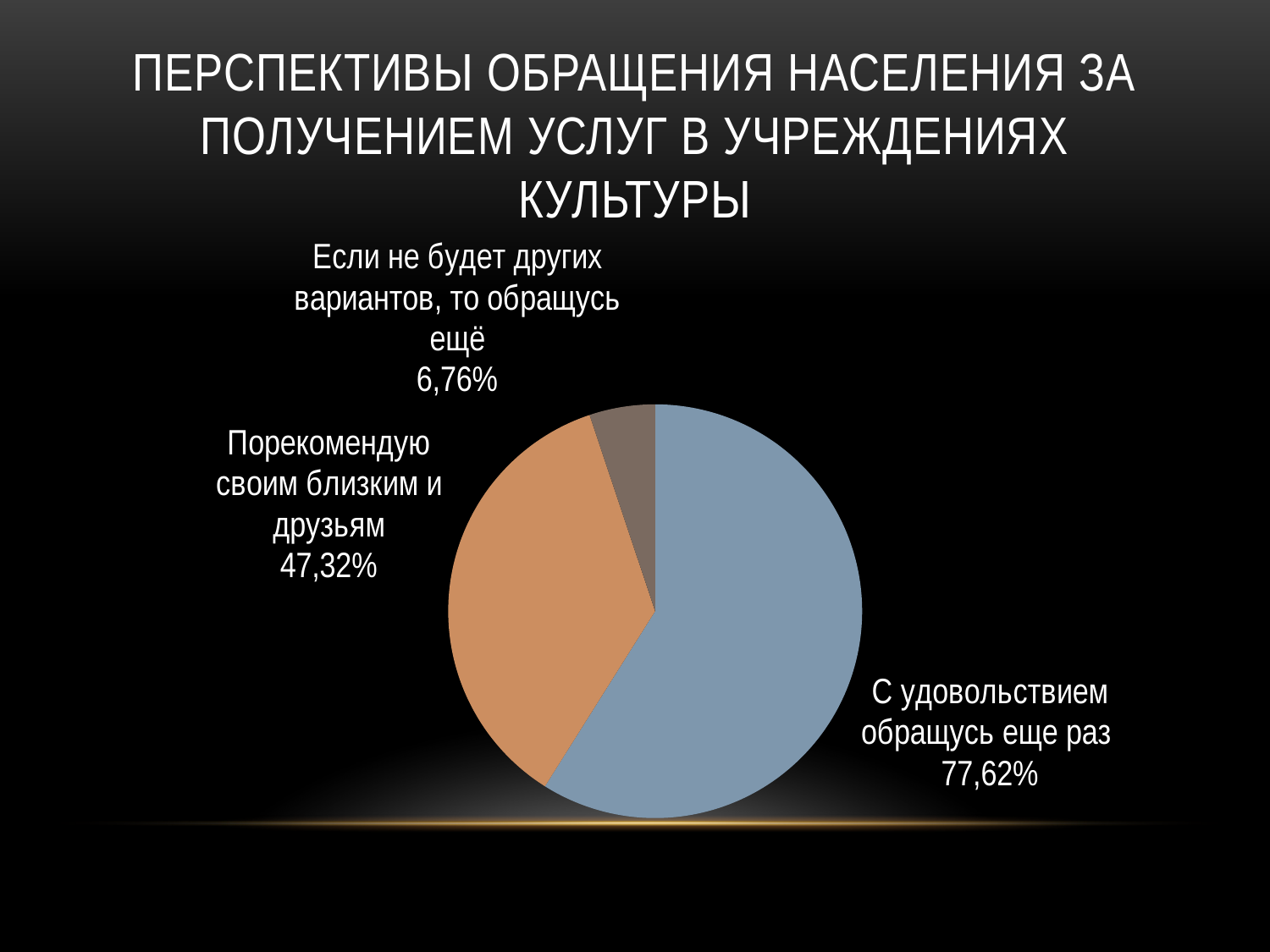
Which category has the largest slice of the pie? С удовольствием обращусь еще раз What percentage is shown for "Порекомендую своим близким и друзьям"? 47,32% What kind of chart is shown on the slide? pie chart What is the difference between the percentages for "Порекомендую своим близким и друзьям" and "Если не будет других вариантов, то обращусь ещё"? 40,56% Which category has the smallest slice of the pie? Если не будет других вариантов, то обращусь ещё How many slices does the pie chart have? 3 What is the difference between the percentages for "С удовольствием обращусь еще раз" and "Порекомендую своим близким и друзьям"? 30,30% What percentage is shown for "Если не будет других вариантов, то обращусь ещё"? 6,76% What colour is the slice for "Порекомендую своим близким и друзьям"? orange What is the title of the slide containing the pie chart? Перспективы обращения населения за получением услуг в учреждениях культуры Which is larger: the percentage for "Порекомендую своим близким и друзьям" or for "Если не будет других вариантов, то обращусь ещё"? Порекомендую своим близким и друзьям What percentage is shown for "С удовольствием обращусь еще раз"? 77,62%